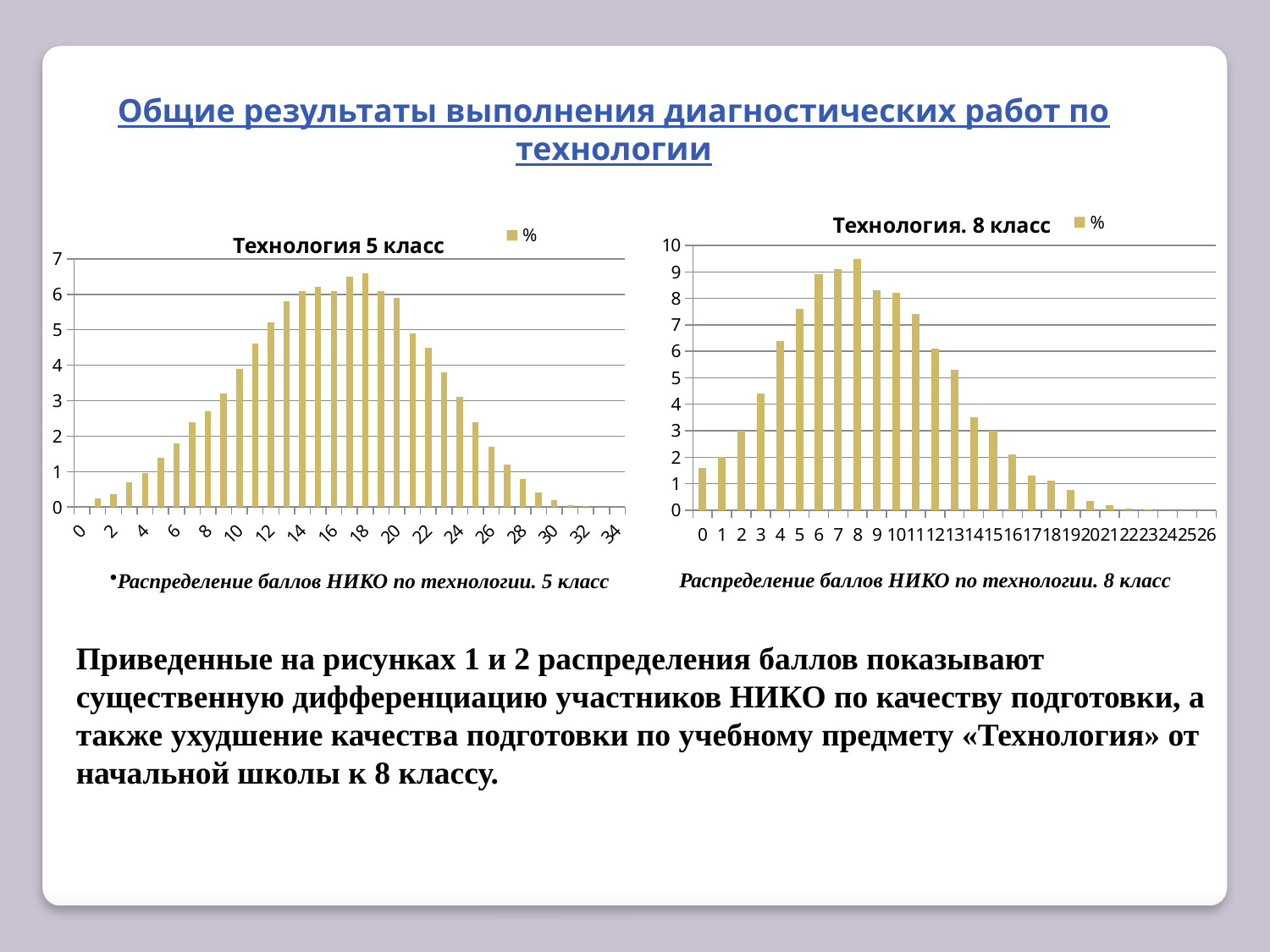
What is the legend entry shown for the left chart "Технология 5 класс"? % In the left chart "Технология 5 класс", is the value for score 26 greater or less than 2? less What is the title of the right chart? Технология. 8 класс How many score categories are shown on the x axis of the right chart "Технология. 8 класс"? 27 How many series does the legend of the right chart "Технология. 8 класс" list? 1 In the right chart "Технология. 8 класс", which score has the highest bar? 8 In the right chart "Технология. 8 класс", is the value for score 16 greater or less than 3? less In the left chart "Технология 5 класс", which score has the larger value, 14 or 22? 14 In the left chart "Технология 5 класс", which score has the highest bar? 18 What kind of chart is the left chart titled "Технология 5 класс"? bar chart In the right chart "Технология. 8 класс", is the value for score 8 greater or less than 9? greater